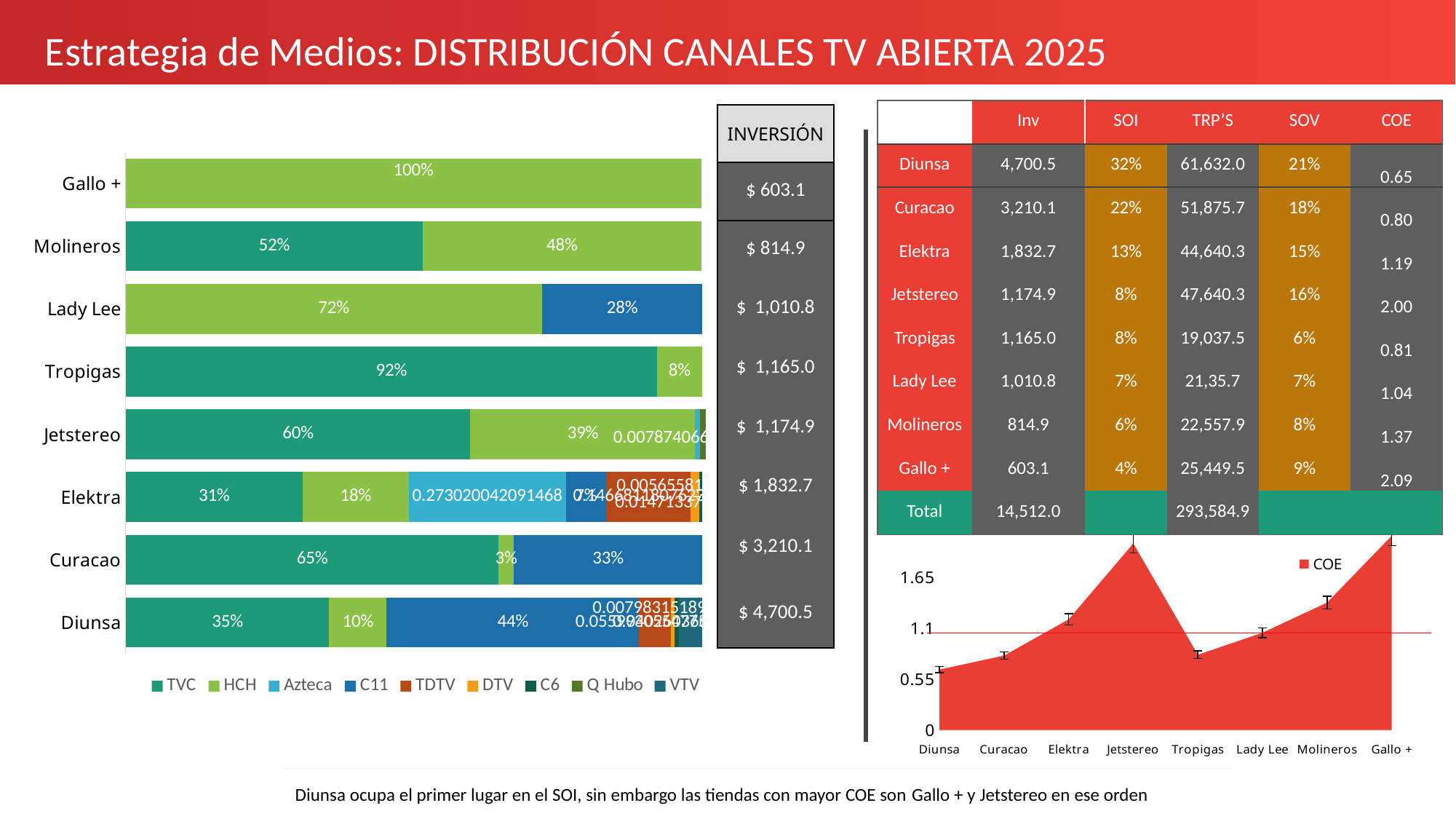
In the left bar chart, what is the C11 share for Diunsa? 44% In the COE chart at the bottom right, is the value for Tropigas greater or less than 1.1? less In the left bar chart, what is the difference between the TVC share and the HCH share for Molineros? 4% What kind of chart is the chart on the left of the slide? stacked bar chart In the COE chart at the bottom right, which store has the lowest COE? Diunsa In the left bar chart, which is larger for Curacao: the TVC share or the C11 share? TVC What kind of chart is the COE chart at the bottom right of the slide? area chart In the left bar chart, how many series does the legend list? 9 In the COE chart at the bottom right, is the value for Jetstereo greater or less than 1.65? greater In the left bar chart, how many stores (categories) are shown? 8 In the left bar chart, what is the TVC share for Tropigas? 92% In the left bar chart, what is the HCH share for Lady Lee? 72%